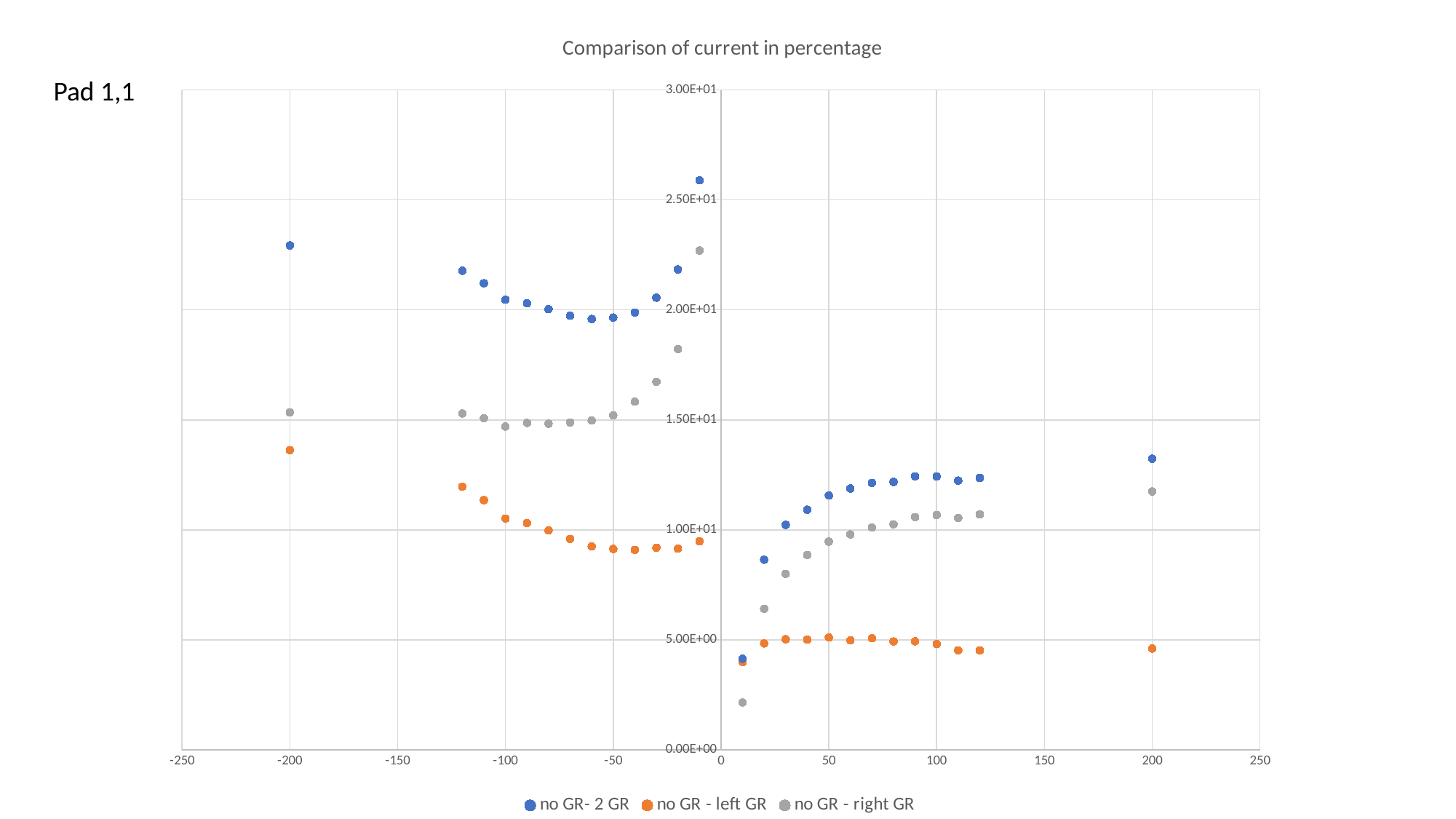
Which series is shown in orange in the legend? no GR - left GR Is the value of the 'no GR - left GR' series at x = -200 greater or less than 10? greater How many series does the legend list? 3 What is the title of the chart? Comparison of current in percentage Is the value of the 'no GR - right GR' series at x = 10 greater or less than 5? less At x = -200, which series has the larger value, 'no GR- 2 GR' or 'no GR - left GR'? no GR- 2 GR What kind of chart is shown on the slide? scatter chart Is the value of the 'no GR - left GR' series at x = -50 greater or less than 10? less Does the 'no GR- 2 GR' series rise or fall as x increases from 20 to 90? rise Which series reaches the highest value anywhere on the chart? no GR- 2 GR